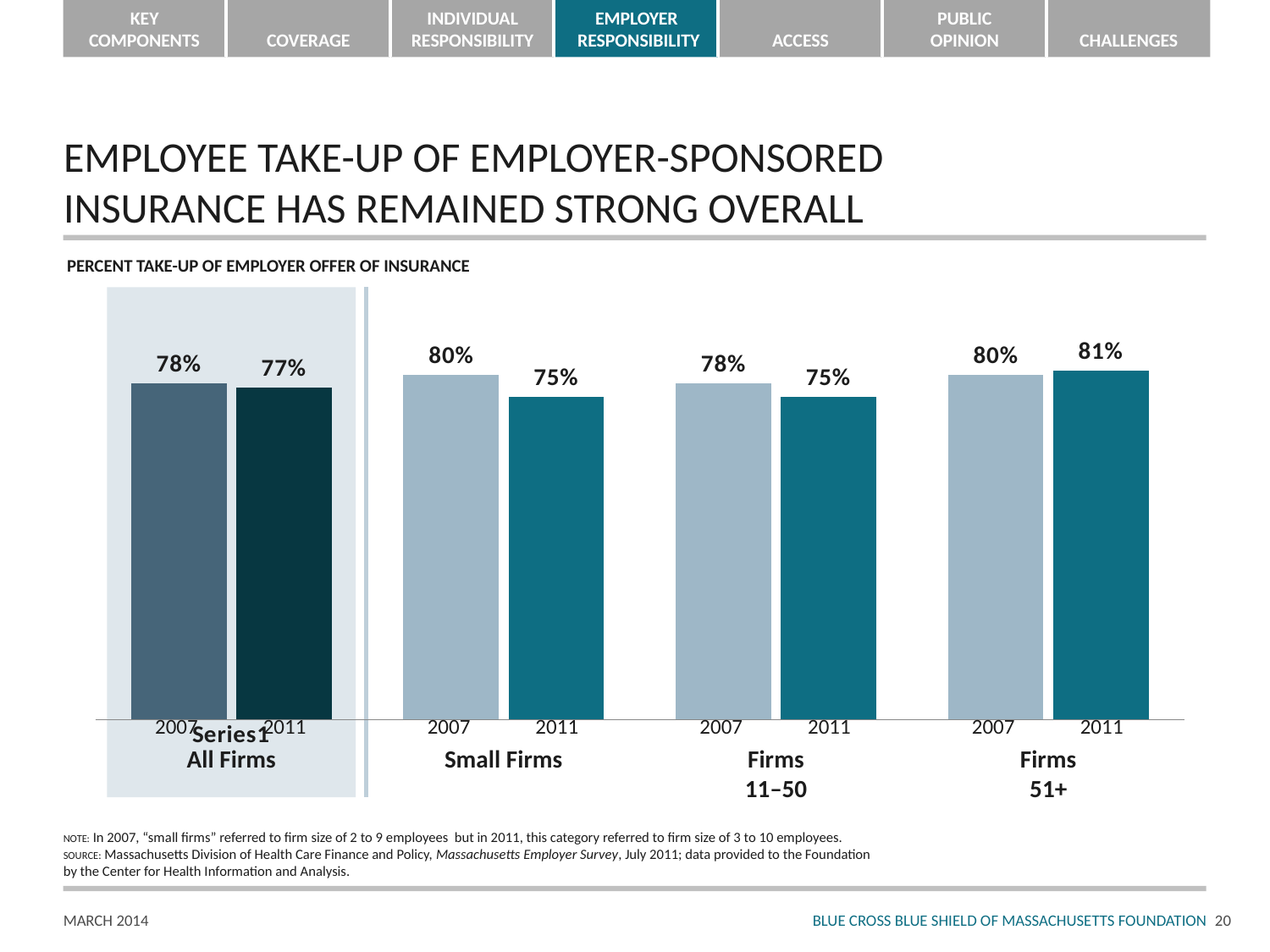
What type of chart is used on this slide? Bar chart Which firm group and year has the highest percent take-up shown on the chart? Firms 51+ in 2011 (81%) Which is larger: the 2007 take-up for Firms 51+ or the 2011 take-up for Firms 51+? 2011 (81%) What was the percent take-up for Small Firms in 2011? 75% By how many percentage points did take-up for Small Firms fall from 2007 to 2011? 5 percentage points Did the take-up for All Firms rise or fall from 2007 to 2011? Fall What was the percent take-up for Firms 11–50 in 2007? 78% What was the percent take-up for Firms 51+ in 2011? 81% How many firm groups are shown on the chart? 4 What is the lowest percent take-up value shown on the chart? 75% What was the percent take-up of employer offer of insurance for All Firms in 2007? 78% What is the title of the chart on this slide? PERCENT TAKE-UP OF EMPLOYER OFFER OF INSURANCE